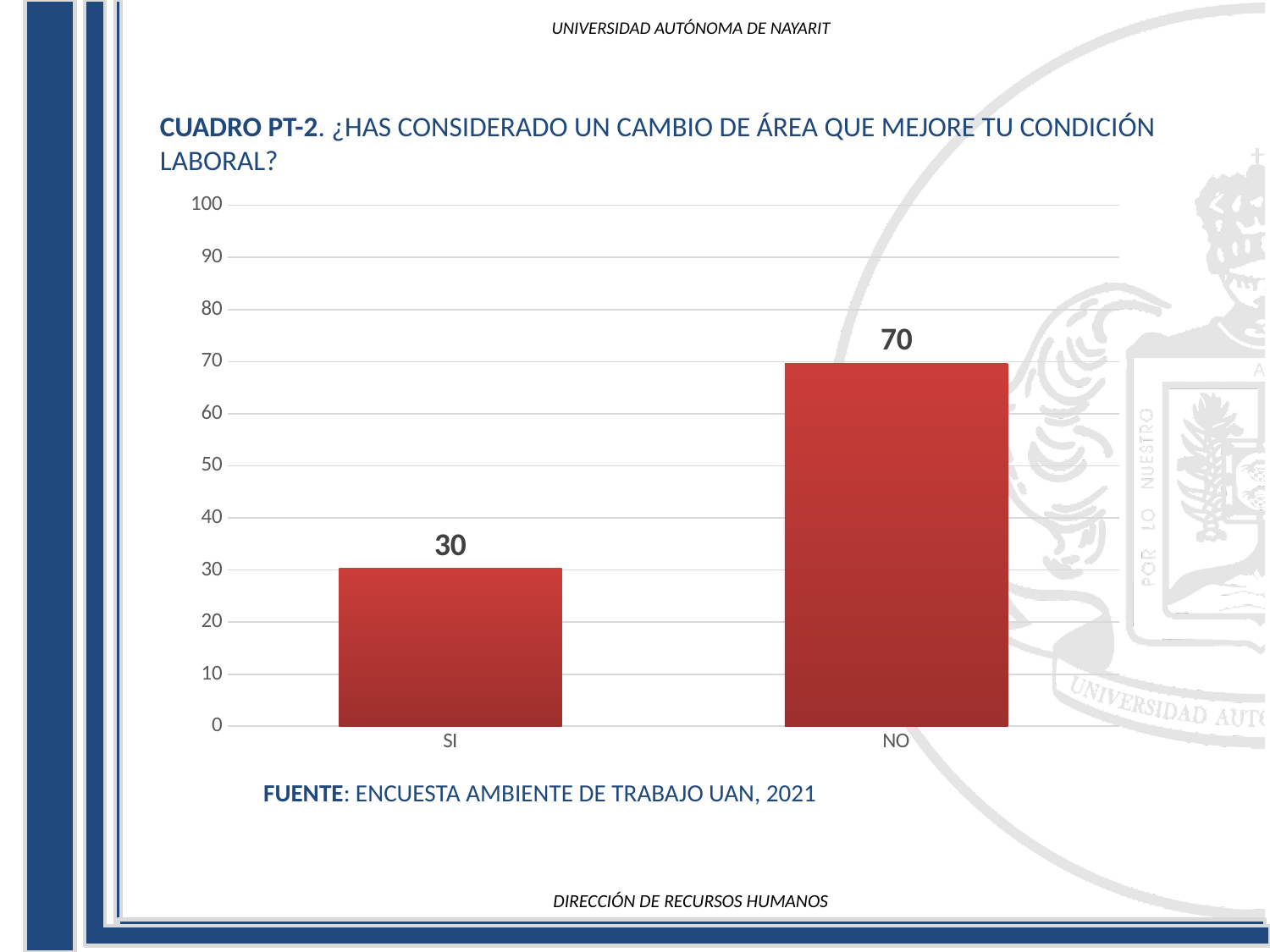
What is the highest value shown on the y axis? 100 What is the value for SI? 30 Is the value for SI greater or less than 40? less What is the value for NO? 70 How many categories are shown on the x axis? 2 What kind of chart is shown on the slide? bar chart Which category has the highest value? NO Is the value for NO greater or less than 60? greater Which category has the lowest value? SI What is the difference between the values for NO and SI? 40 What is the source cited below the chart? ENCUESTA AMBIENTE DE TRABAJO UAN, 2021 Which is larger, the value for SI or the value for NO? NO